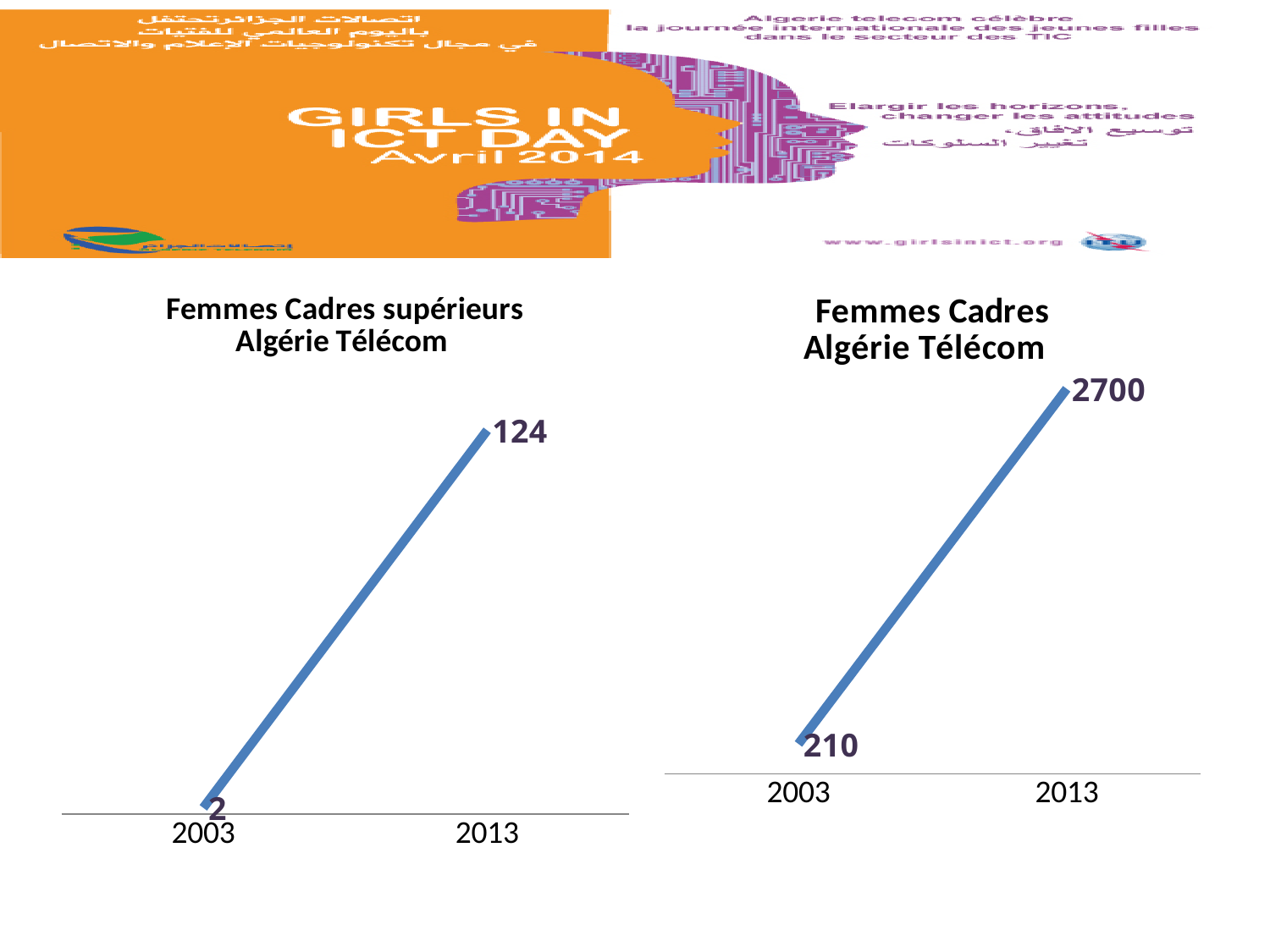
In the 'Femmes Cadres supérieurs Algérie Télécom' chart, what is the value for 2003? 2 How many charts are shown on the slide? 2 What kind of chart is the 'Femmes Cadres Algérie Télécom' chart? Line chart In the 'Femmes Cadres supérieurs Algérie Télécom' chart, what is the value for 2013? 124 In the 'Femmes Cadres supérieurs Algérie Télécom' chart, which year has the lowest value? 2003 In the 'Femmes Cadres Algérie Télécom' chart, what is the difference between the 2013 and 2003 values? 2490 In the 'Femmes Cadres Algérie Télécom' chart, what is the value for 2003? 210 In the 'Femmes Cadres Algérie Télécom' chart, which year has the higher value? 2013 In the 'Femmes Cadres supérieurs Algérie Télécom' chart, do the values rise or fall from 2003 to 2013? Rise In the 'Femmes Cadres supérieurs Algérie Télécom' chart, what is the difference between the 2013 and 2003 values? 122 How many data points are plotted in the 'Femmes Cadres Algérie Télécom' chart? 2 In the 'Femmes Cadres Algérie Télécom' chart, what is the value for 2013? 2700